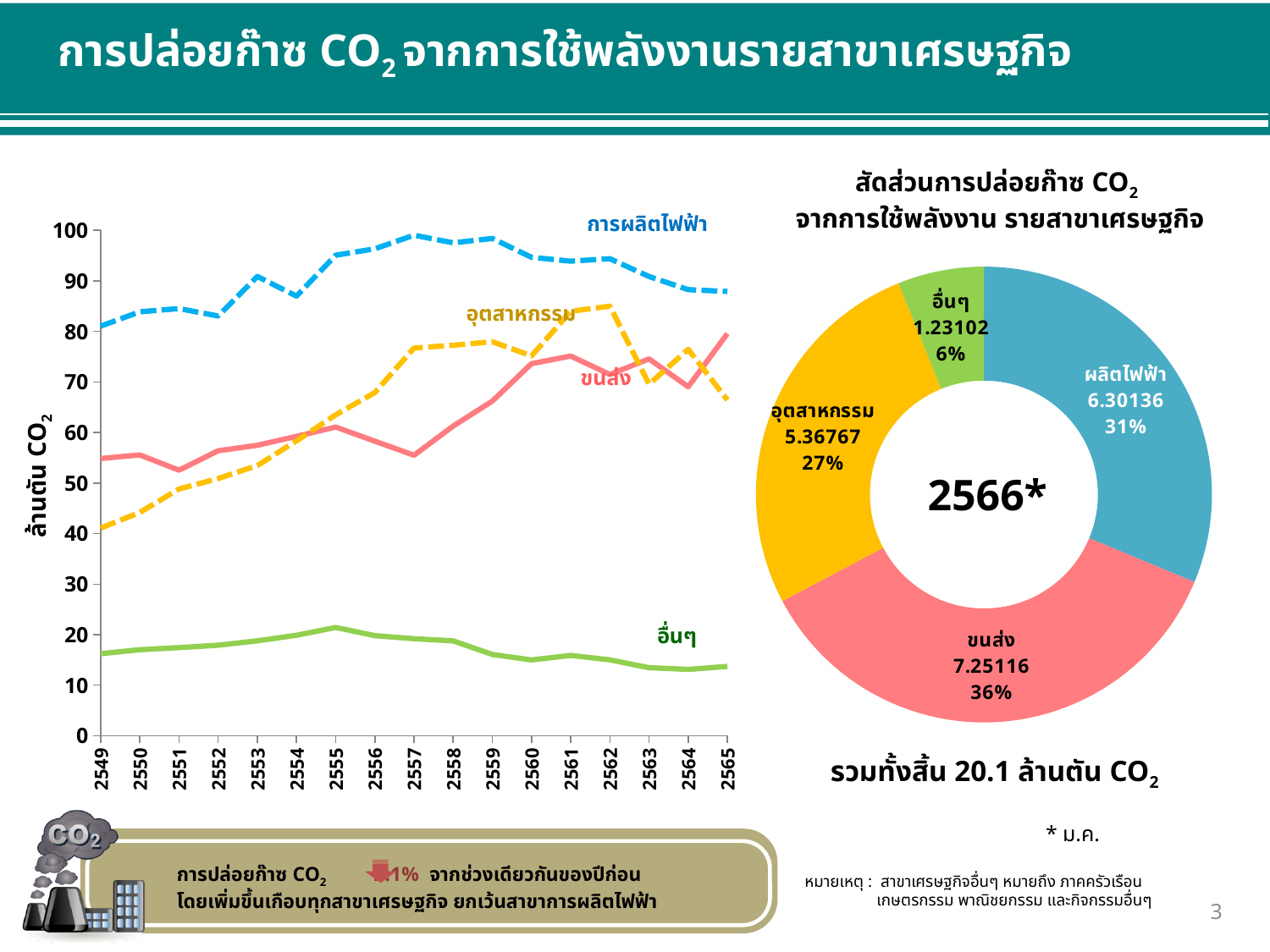
In the line chart on the left, does the อุตสาหกรรม series generally rise or fall from 2549 to 2562? rise In the doughnut chart on the right, how many sectors are shown? 4 In the line chart on the left, which series has the lowest values across all years? อื่นๆ In the doughnut chart on the right, what percentage share is shown for ผลิตไฟฟ้า? 31% In the doughnut chart on the right, what is the difference in percentage points between ขนส่ง and อุตสาหกรรม? 9% In the doughnut chart on the right, what value is shown for ขนส่ง? 7.25116 In the doughnut chart on the right, which sector has the largest share? ขนส่ง In the doughnut chart on the right, what year is printed in the centre? 2566* In the line chart on the left, how many series are plotted? 4 What kind of chart is the chart on the left side of the slide? line chart In the line chart on the left, is the value for การผลิตไฟฟ้า in 2557 greater or less than 90? greater In the doughnut chart on the right, which sector has the smallest share? อื่นๆ